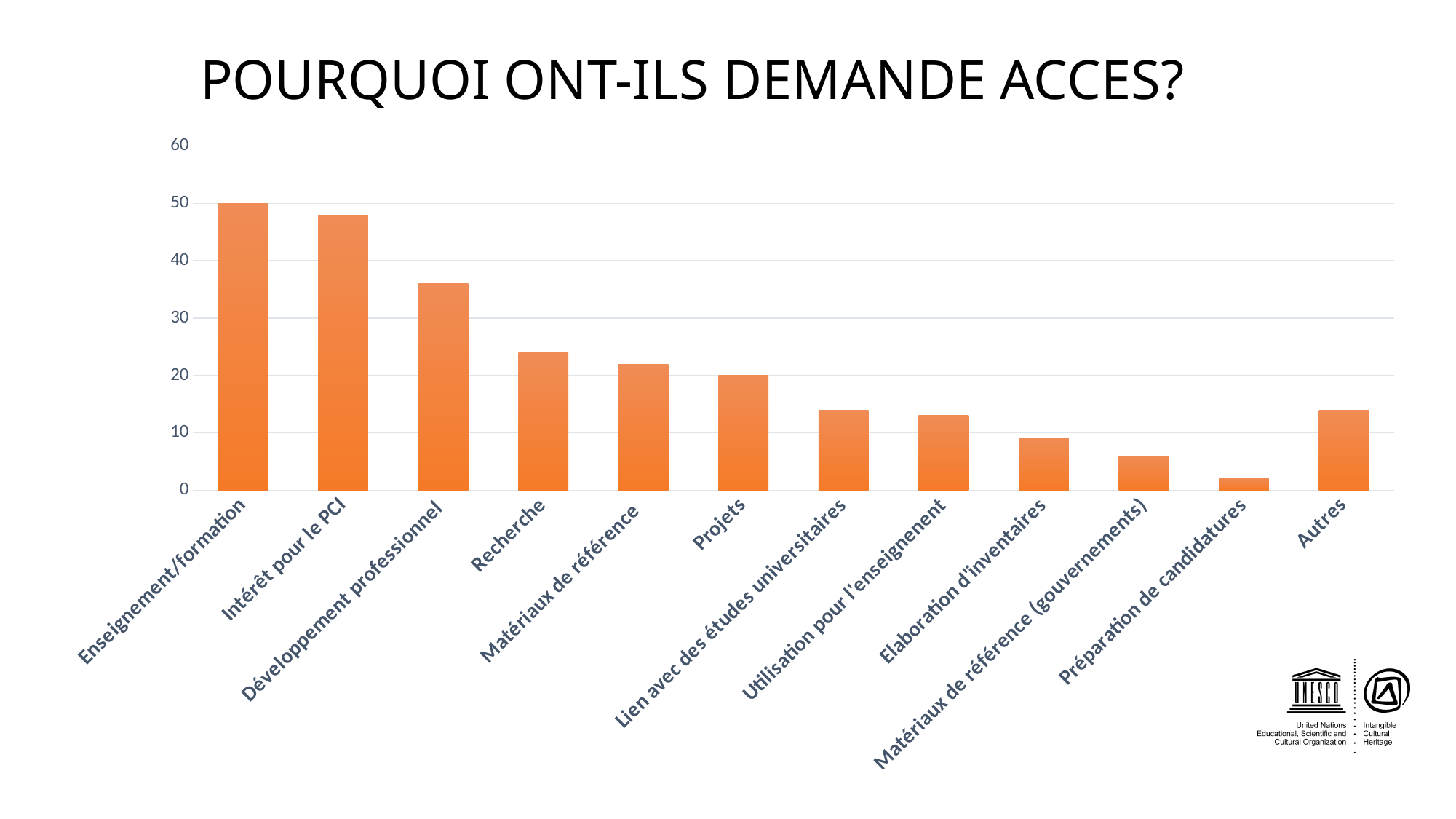
What is the value for Projets? 20 What is the value for Enseignement/formation? 50 Which is larger, the value for Recherche or the value for Projets? Recherche Which is larger, the value for Intérêt pour le PCI or the value for Développement professionnel? Intérêt pour le PCI Which category has the lowest value? Préparation de candidatures Is the value for Elaboration d'inventaires greater or less than 10? less How many categories are shown on the x axis? 12 Which category has the highest value? Enseignement/formation Is the value for Développement professionnel greater or less than 40? less Is the value for Recherche greater or less than 20? greater What kind of chart is shown on the slide? bar chart What is the title of the chart? POURQUOI ONT-ILS DEMANDE ACCES?